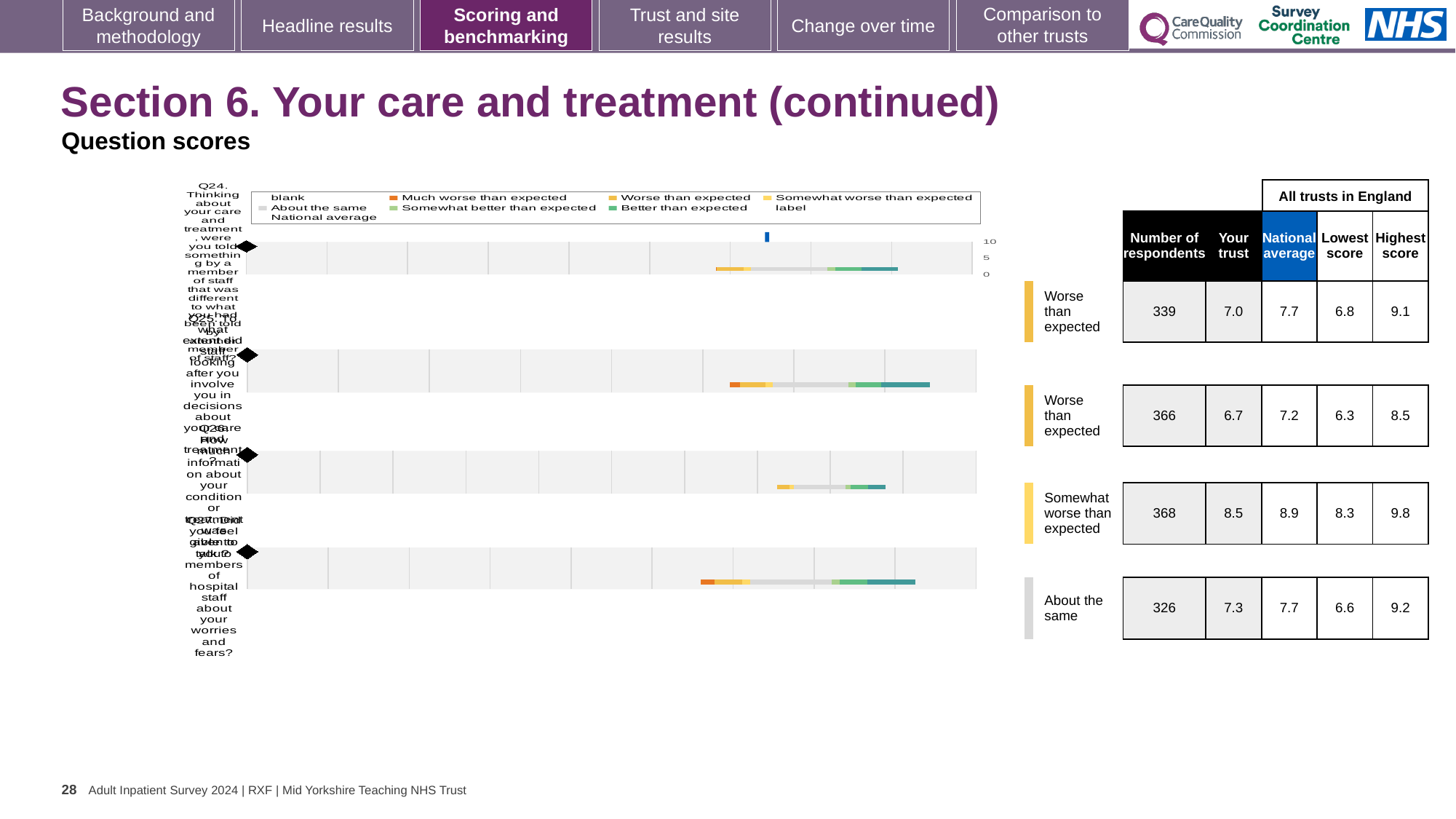
What is the national average score for Q25 (the second row)? 7.2 What kind of chart is shown on the left of the slide? bar chart What benchmark category is shown for Q26 (the third row)? Somewhat worse than expected What is the 'Your trust' score for Q24 (the first row)? 7.0 Which question has the highest 'Your trust' score? Q26 How many questions (rows) are plotted in the chart? 4 How many respondents answered Q26 (the third row)? 368 For Q25, which is larger: the trust score or the national average? National average What is the difference between the national average and the trust score for Q24? 0.7 What benchmark category is shown for Q27 (the fourth row)? About the same Which question has the lowest number of respondents? Q27 What is the highest score among all trusts in England for Q27 (the fourth row)? 9.2